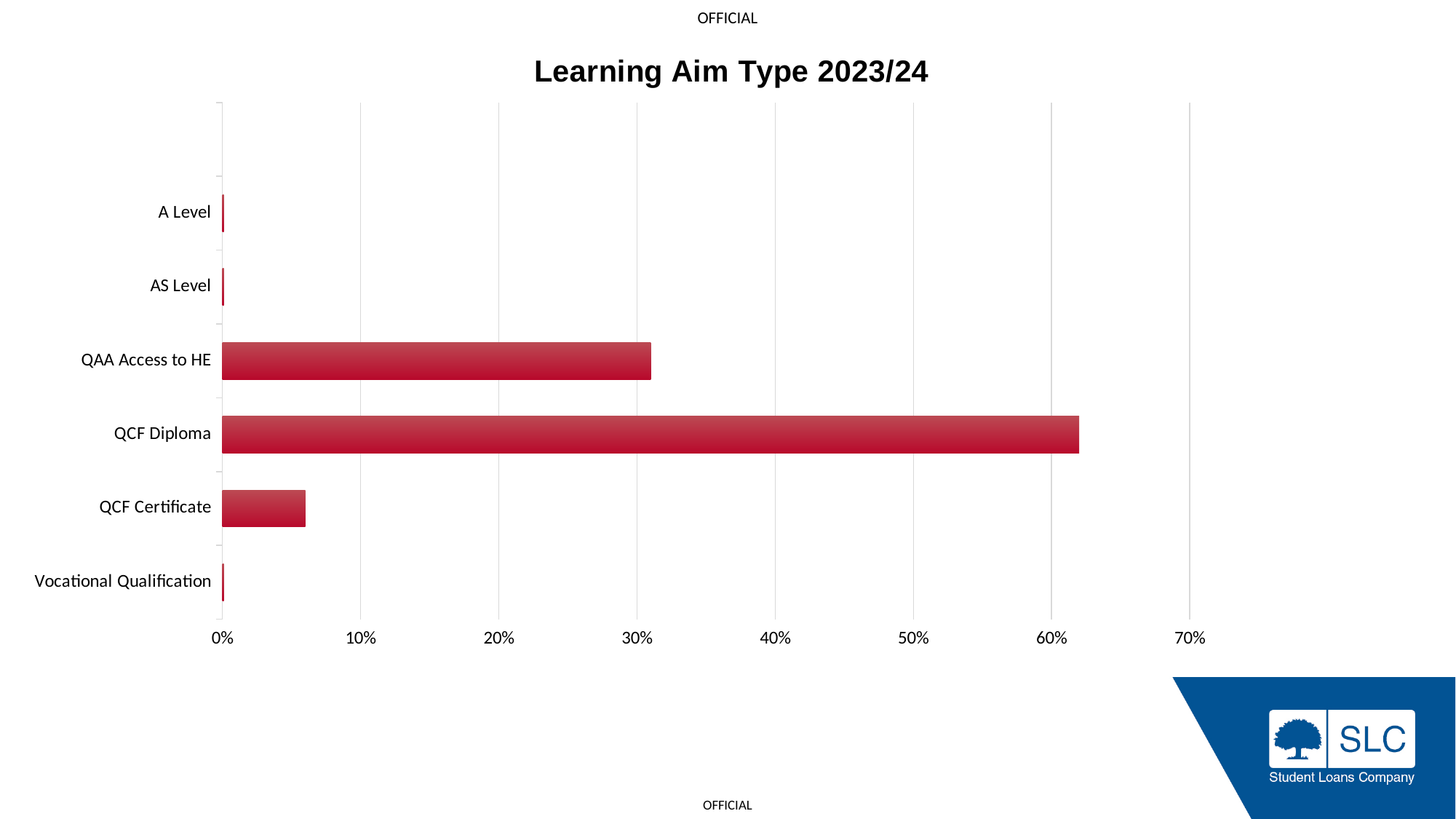
Is the value for QCF Certificate greater or less than 10%? less How many learning aim type categories are plotted in the chart? 6 Which is larger, the value for QAA Access to HE or the value for QCF Certificate? QAA Access to HE Is the value for QCF Diploma greater or less than 60%? greater What type of chart is shown on the slide? bar chart Which learning aim type has the highest value? QCF Diploma Which is larger, the value for QCF Diploma or the value for QAA Access to HE? QCF Diploma What colour are the bars in the chart? red Is the value for QAA Access to HE greater or less than 40%? less What is the title of the chart? Learning Aim Type 2023/24